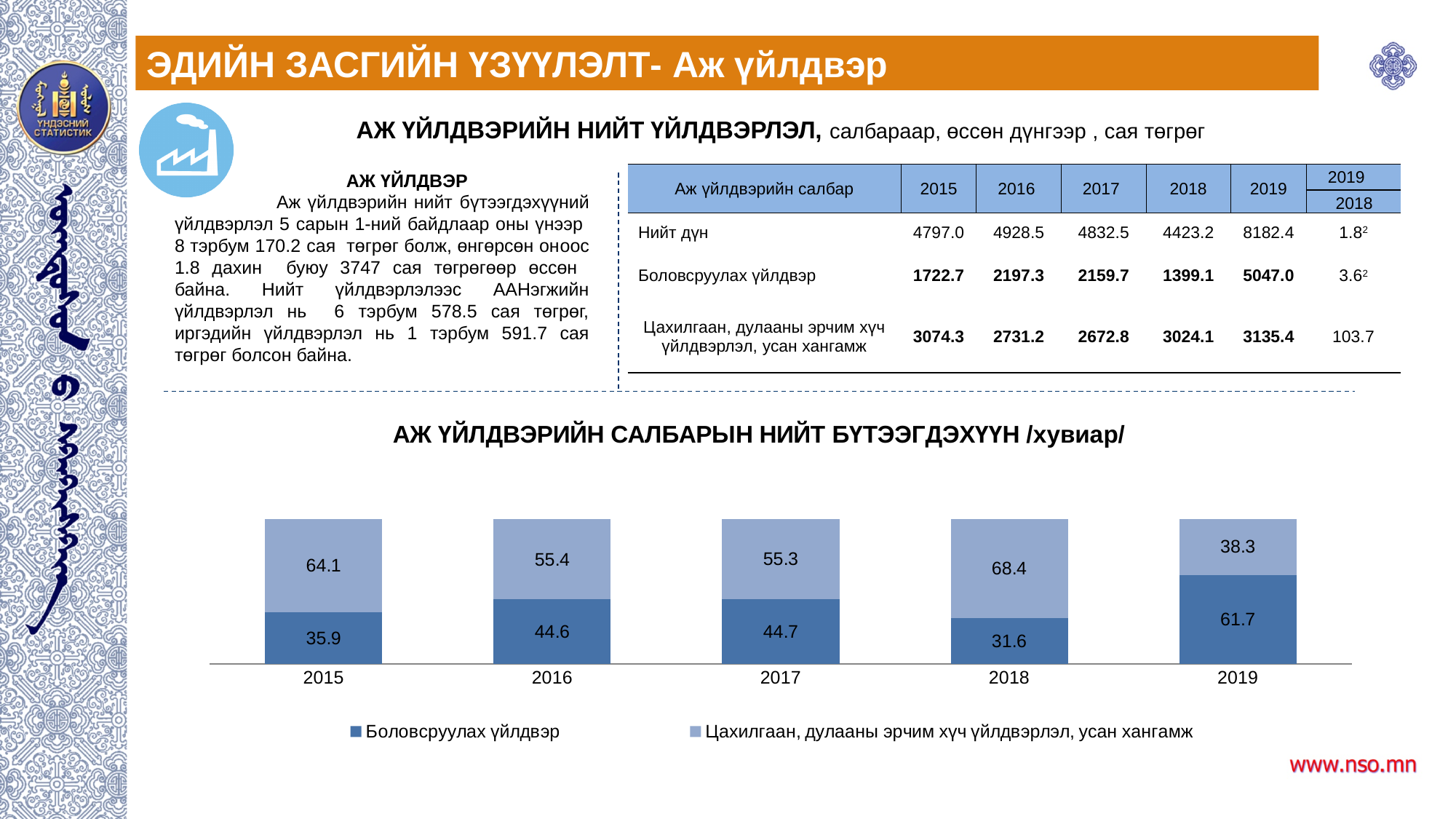
What type of chart is shown on the slide? Stacked bar chart What is the difference between the Цахилгаан, дулааны эрчим хүч үйлдвэрлэл, усан хангамж value in 2018 and in 2019? 30.1 In which year is the value for Боловсруулах үйлдвэр lowest? 2018 What is the value for Боловсруулах үйлдвэр in 2019? 61.7 Which is larger in 2016: Боловсруулах үйлдвэр or Цахилгаан, дулааны эрчим хүч үйлдвэрлэл, усан хангамж? Цахилгаан, дулааны эрчим хүч үйлдвэрлэл, усан хангамж What is the total of the stacked bar for 2017? 100.0 What is the value for Цахилгаан, дулааны эрчим хүч үйлдвэрлэл, усан хангамж in 2018? 68.4 What is the value for Боловсруулах үйлдвэр in 2015? 35.9 In which year is the value for Боловсруулах үйлдвэр highest? 2019 How many years are shown on the x axis of the chart? 5 How many series does the chart legend list? 2 What is the title of the chart? АЖ ҮЙЛДВЭРИЙН САЛБАРЫН НИЙТ БҮТЭЭГДЭХҮҮН /хувиар/